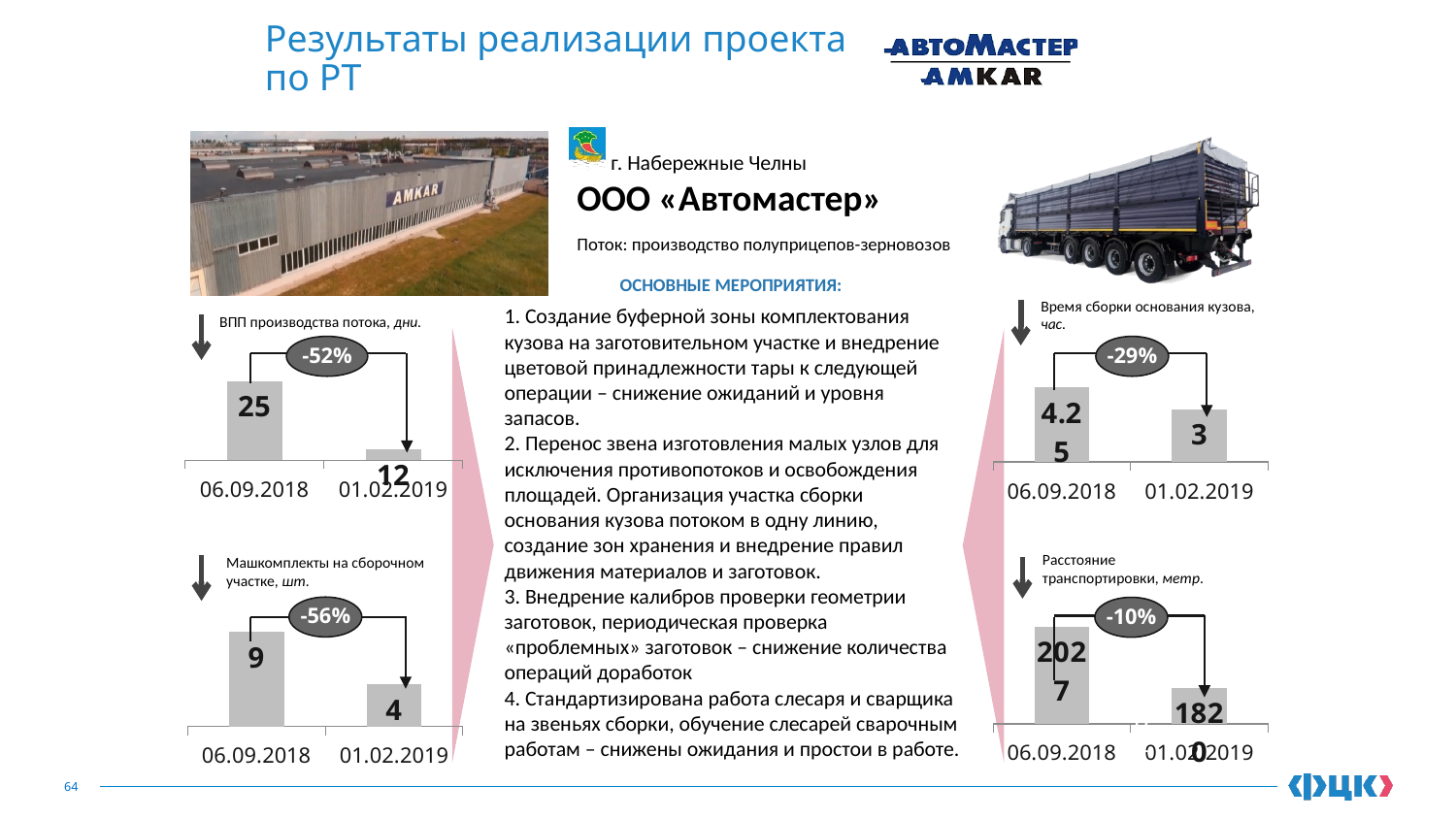
On the chart 'ВПП производства потока, дни', what percentage change is shown between the two dates? -52% On the chart 'ВПП производства потока, дни', what is the value for 01.02.2019? 12 On the chart 'Машкомплекты на сборочном участке, шт.', what percentage change is shown? -56% On the chart 'ВПП производства потока, дни', what is the difference between the 06.09.2018 and 01.02.2019 values? 13 On the chart 'Расстояние транспортировки, метр.', what percentage change is shown? -10% On the chart 'Машкомплекты на сборочном участке, шт.', what is the value for 01.02.2019? 4 On the chart 'ВПП производства потока, дни', what is the value for 06.09.2018? 25 What type of chart is used for 'ВПП производства потока, дни'? Bar chart On the chart 'Время сборки основания кузова, час.', what is the value for 01.02.2019? 3 On the chart 'Машкомплекты на сборочном участке, шт.', what is the value for 06.09.2018? 9 On the chart 'Время сборки основания кузова, час.', what percentage change is shown? -29% On the chart 'Машкомплекты на сборочном участке, шт.', which date has the higher value? 06.09.2018